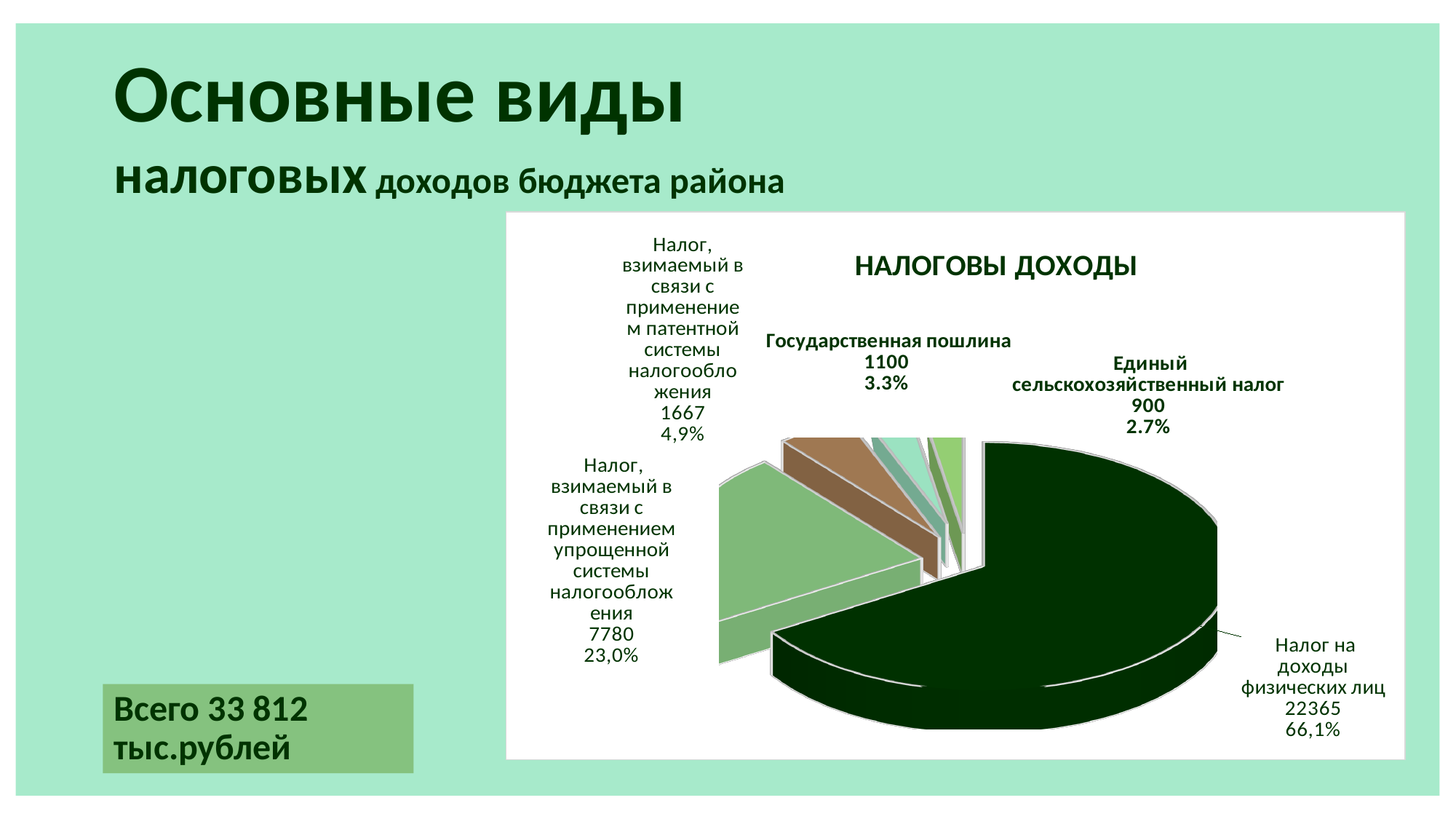
Which category has the smallest slice? Единый сельскохозяйственный налог Which is larger: the value for Государственная пошлина or the value for Единый сельскохозяйственный налог? Государственная пошлина What is the title of the chart? НАЛОГОВЫ ДОХОДЫ Which category has the largest slice? Налог на доходы физических лиц What is the value for the tax collected under the simplified taxation system (упрощенной системы налогообложения)? 7780 How many slices does the pie chart have? 5 What is the difference between the value for Налог на доходы физических лиц and the value for the tax under the simplified taxation system? 14585 What type of chart is shown on the slide? pie chart What share of the pie does Налог на доходы физических лиц represent? 66,1% What is the value for Налог на доходы физических лиц? 22365 What share of the pie does Единый сельскохозяйственный налог represent? 2.7% What is the value for Государственная пошлина? 1100